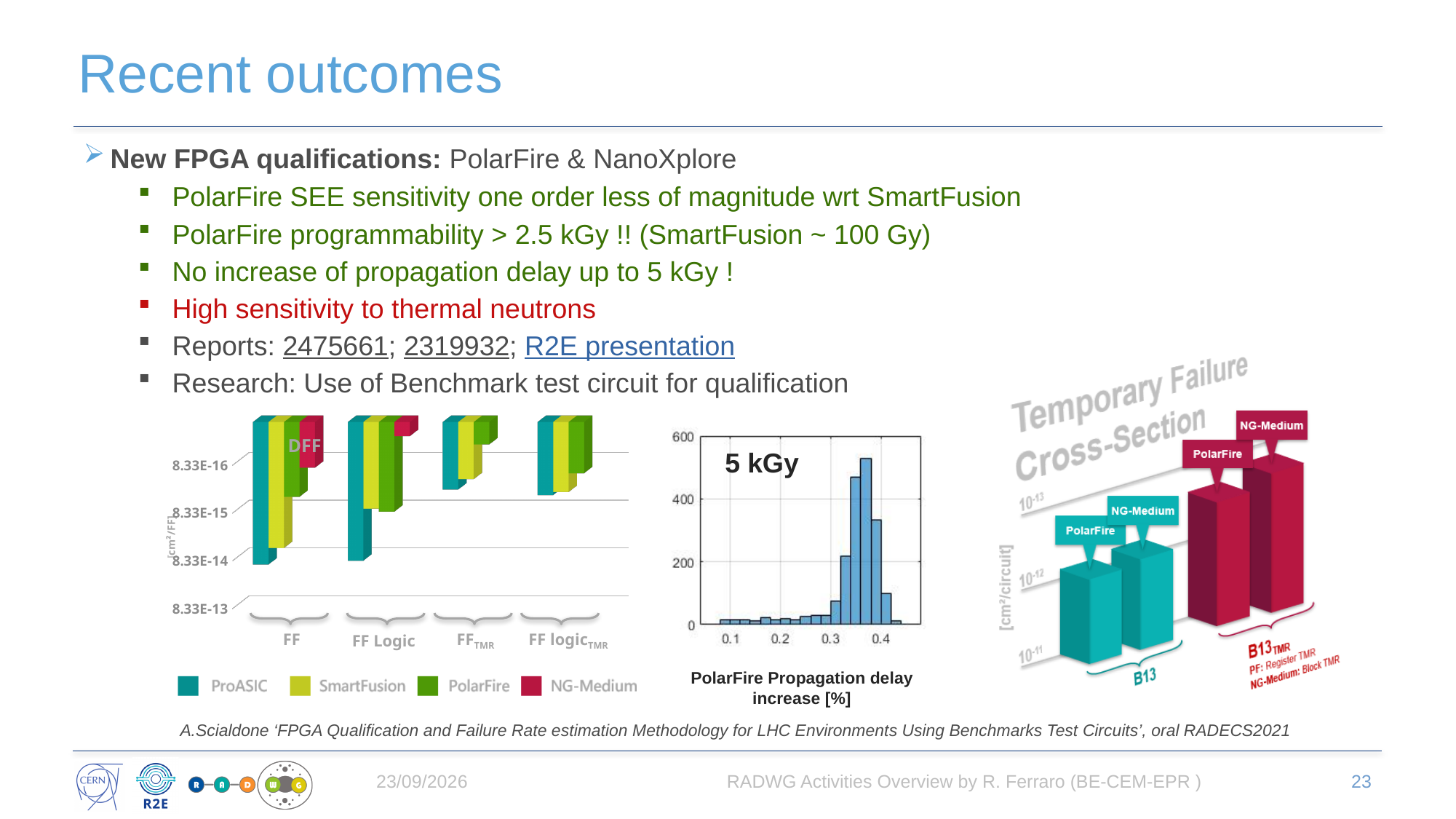
In the middle histogram, is the tallest bar greater or less than 400? greater How many categories are shown along the x axis of the left chart? 4 How many series does the legend of the left chart list? 4 What is the highest tick value on the y axis of the middle histogram? 600 What is the title printed under the middle histogram? PolarFire Propagation delay increase [%] In the left chart, how many bars are drawn in the FF TMR group? 3 In the left chart, which series has the longest bar in the FF category? ProASIC In the left chart, which series is shown in teal? ProASIC How many categories are shown on the x axis of the right chart (Temporary Failure Cross-Section)? 2 What kind of chart is the right chart titled Temporary Failure Cross-Section? bar chart What kind of chart is the left chart showing cross-section per FF? bar chart In the middle histogram, what dose is printed inside the plot area? 5 kGy